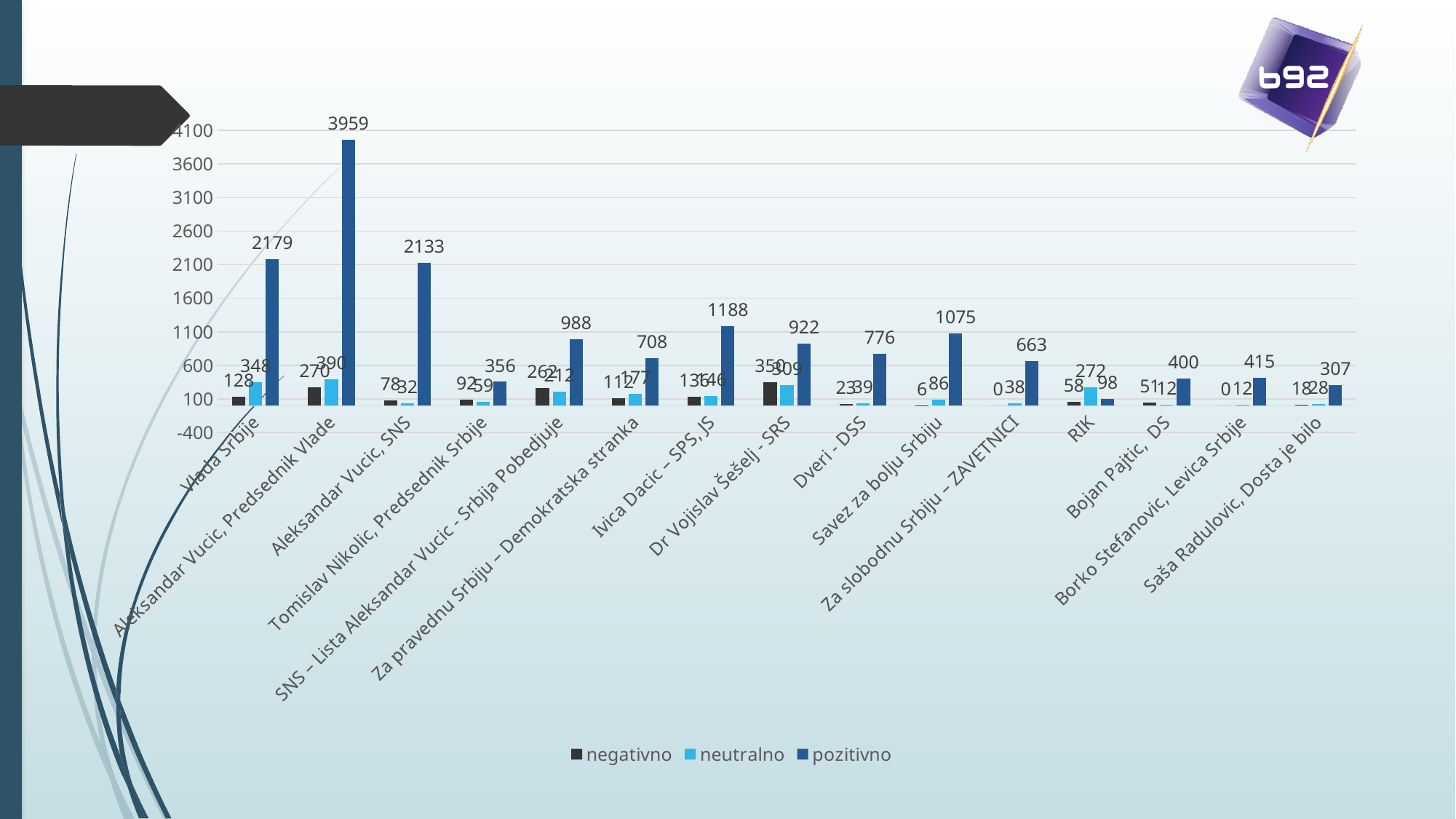
Which category has the highest pozitivno value? Aleksandar Vucic, Predsednik Vlade What is the pozitivno value for Ivica Dacic – SPS, JS? 1188 How many series does the legend list? 3 Which has a larger pozitivno value, Ivica Dacic – SPS, JS or Dr Vojislav Šešelj - SRS? Ivica Dacic – SPS, JS Which category has the lowest pozitivno value? RIK How many categories are shown on the x axis? 15 What is the pozitivno value for Aleksandar Vucic, Predsednik Vlade? 3959 Is the pozitivno value for Savez za bolju Srbiju greater or less than 600? greater What kind of chart is shown on the slide? bar chart What is the difference between the pozitivno values for Aleksandar Vucic, Predsednik Vlade and Vlada Srbije? 1780 What is the neutralno value for RIK? 272 What is the negativno value for Vlada Srbije? 128